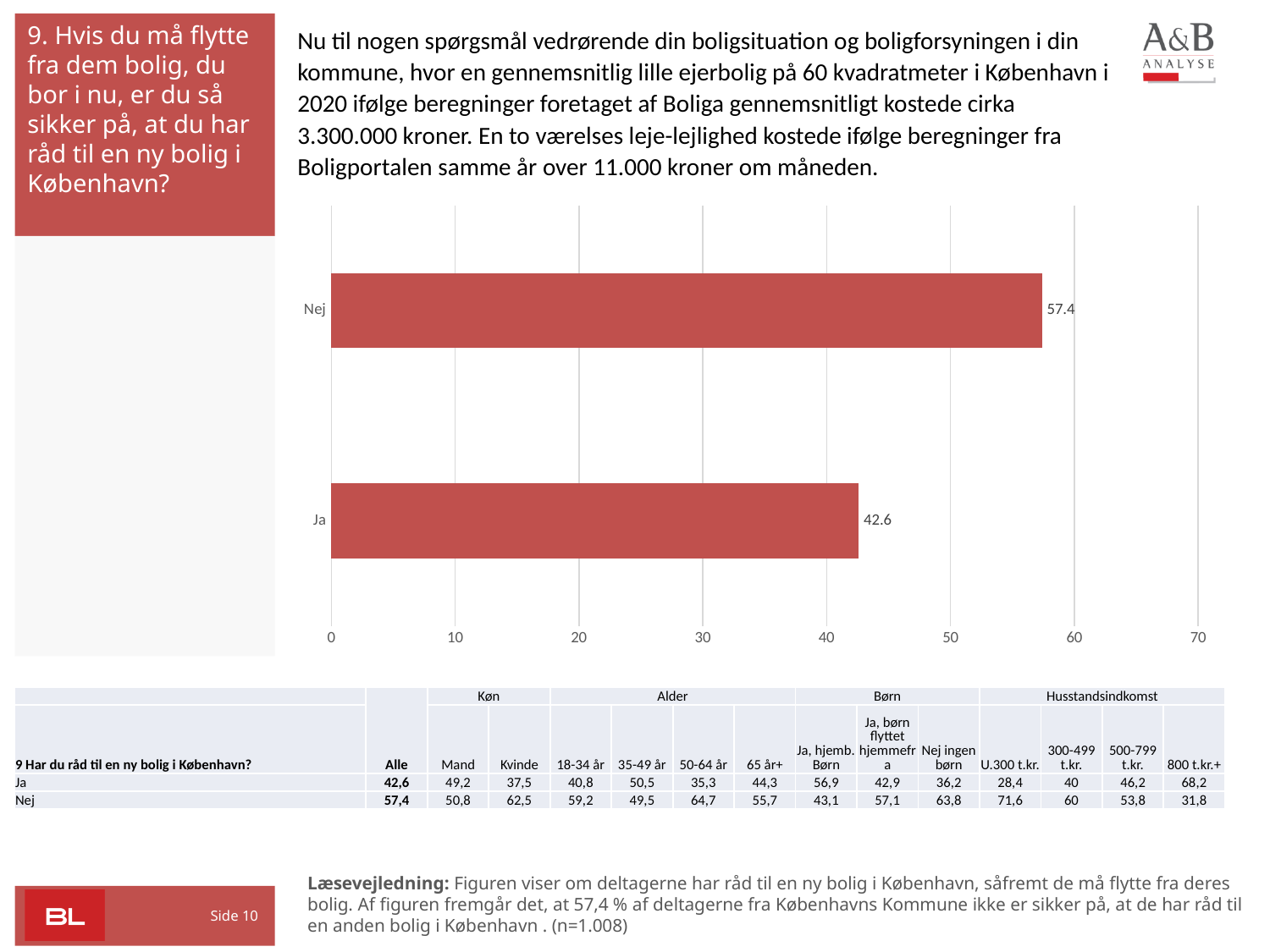
How many categories are shown in the chart? 2 Which is larger, the value for Ja or the value for Nej? Nej What is the value for Nej? 57.4 What is the value for Ja? 42.6 Is the value for Ja greater or less than 40? greater What is the difference between the values for Nej and Ja? 14.8 What is the highest value shown on the x axis of the chart? 70 Is the value for Nej greater or less than 60? less What kind of chart is shown on the slide? bar chart Which category has the highest value? Nej Which category has the lowest value? Ja What colour are the bars in the chart? red